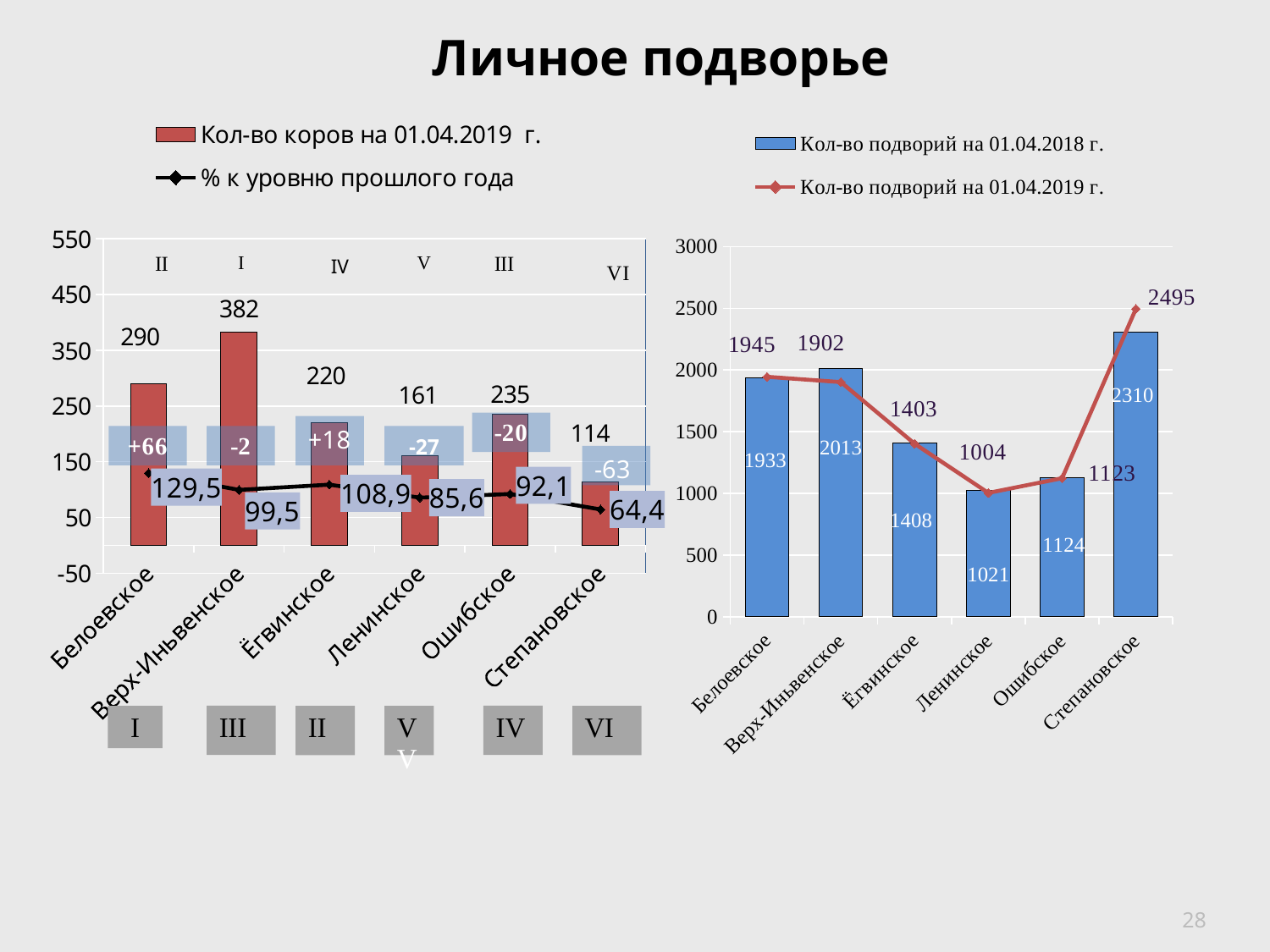
In the right chart, how many series does the legend list? 2 In the right chart, which category has the highest Кол-во подворий на 01.04.2018 г.? Степановское In the left chart, how many cows (Кол-во коров на 01.04.2019 г.) are shown for Верх-Иньвенское? 382 In the right chart, which is larger for Верх-Иньвенское: the 2018 value or the 2019 value? 2018 value (2013) In the right chart, what is the Кол-во подворий на 01.04.2019 г. value for Степановское? 2495 In the left chart, which category has the lowest number of cows? Степановское In the left chart, what is the % к уровню прошлого года value for Ленинское? 85,6 What type of chart is the right chart? Combined bar and line chart In the left chart, which category has the highest number of cows? Верх-Иньвенское In the left chart, what is the difference in the number of cows between Белоевское and Ошибское? 55 In the left chart, how many categories are shown on the x axis? 6 In the right chart, what is the Кол-во подворий на 01.04.2018 г. value for Ленинское? 1021